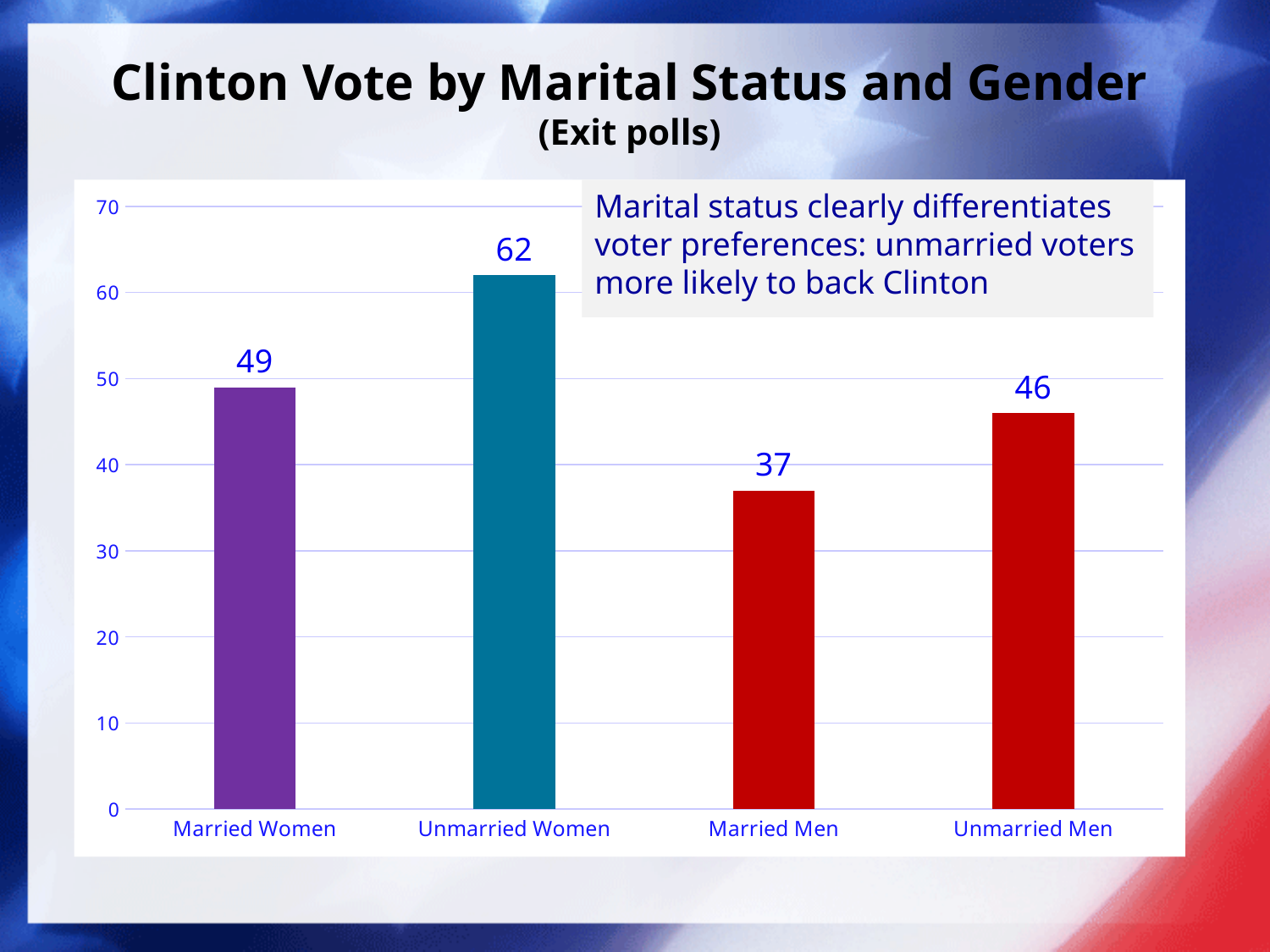
Which category has the lowest value? Married Men What is the difference between the values for Unmarried Men and Married Men? 9 What is the value for Unmarried Men? 46 What is the difference between the values for Unmarried Women and Married Women? 13 What kind of chart is shown on the slide? Bar chart What is the value for Married Men? 37 What is the value for Married Women? 49 What is the title of the chart on the slide? Clinton Vote by Marital Status and Gender (Exit polls) How many categories are shown on the x axis? 4 Which is larger, the value for Married Women or the value for Unmarried Men? Married Women Which category has the highest value? Unmarried Women What is the value for Unmarried Women? 62